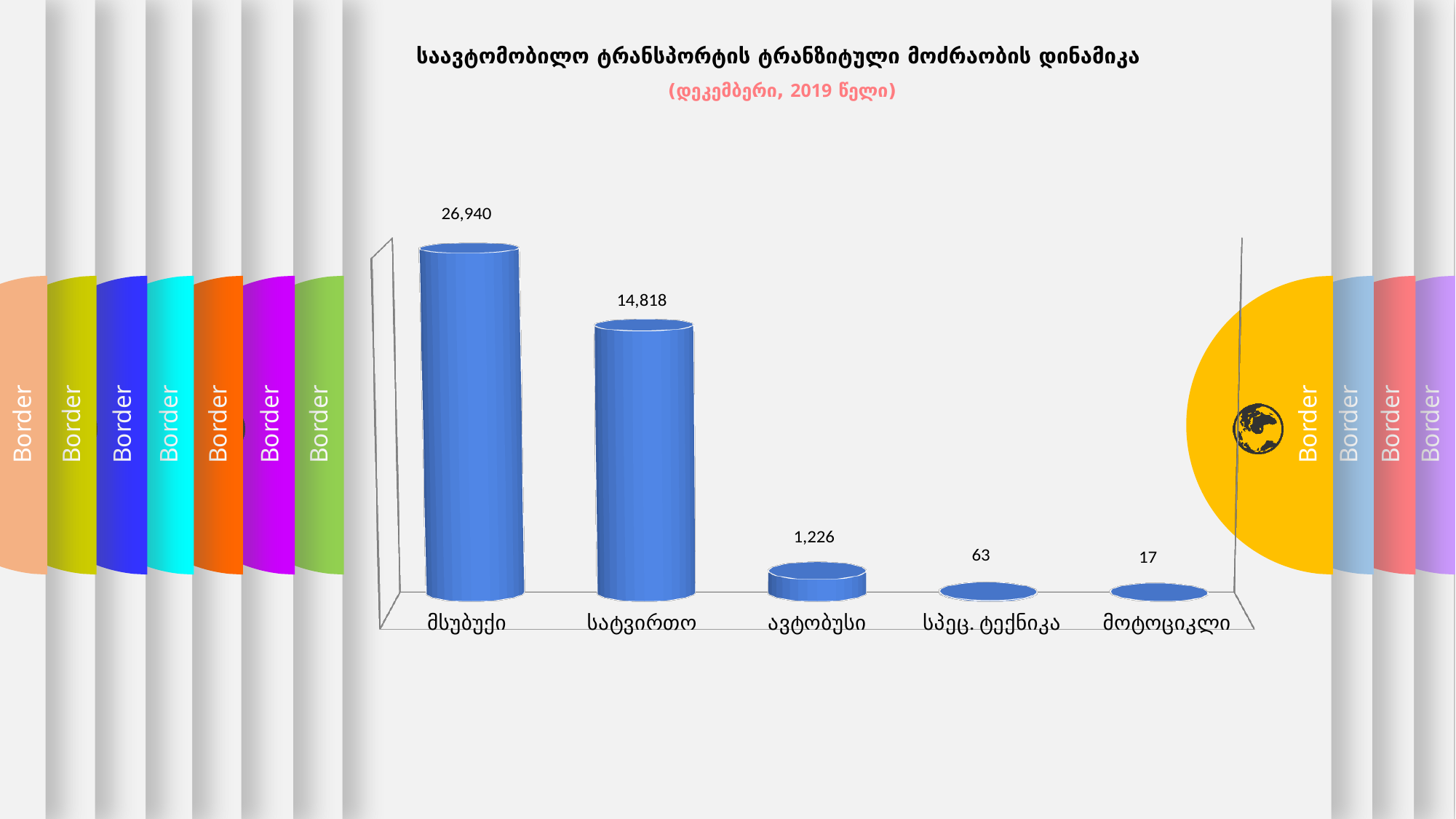
How many categories are shown in the chart? 5 What kind of chart is shown on the slide? Bar chart What is the value for სპეც. ტექნიკა? 63 Which category has the lowest value? მოტოციკლი What is the value for მოტოციკლი? 17 What is the value for სატვირთო? 14,818 Which category has the highest value? მსუბუქი What is the difference between the values for მსუბუქი and სატვირთო? 12,122 What period is given in the subtitle of the chart? დეკემბერი, 2019 წელი Which is larger, the value for ავტობუსი or the value for სპეც. ტექნიკა? ავტობუსი What is the value for ავტობუსი? 1,226 What is the value for მსუბუქი? 26,940